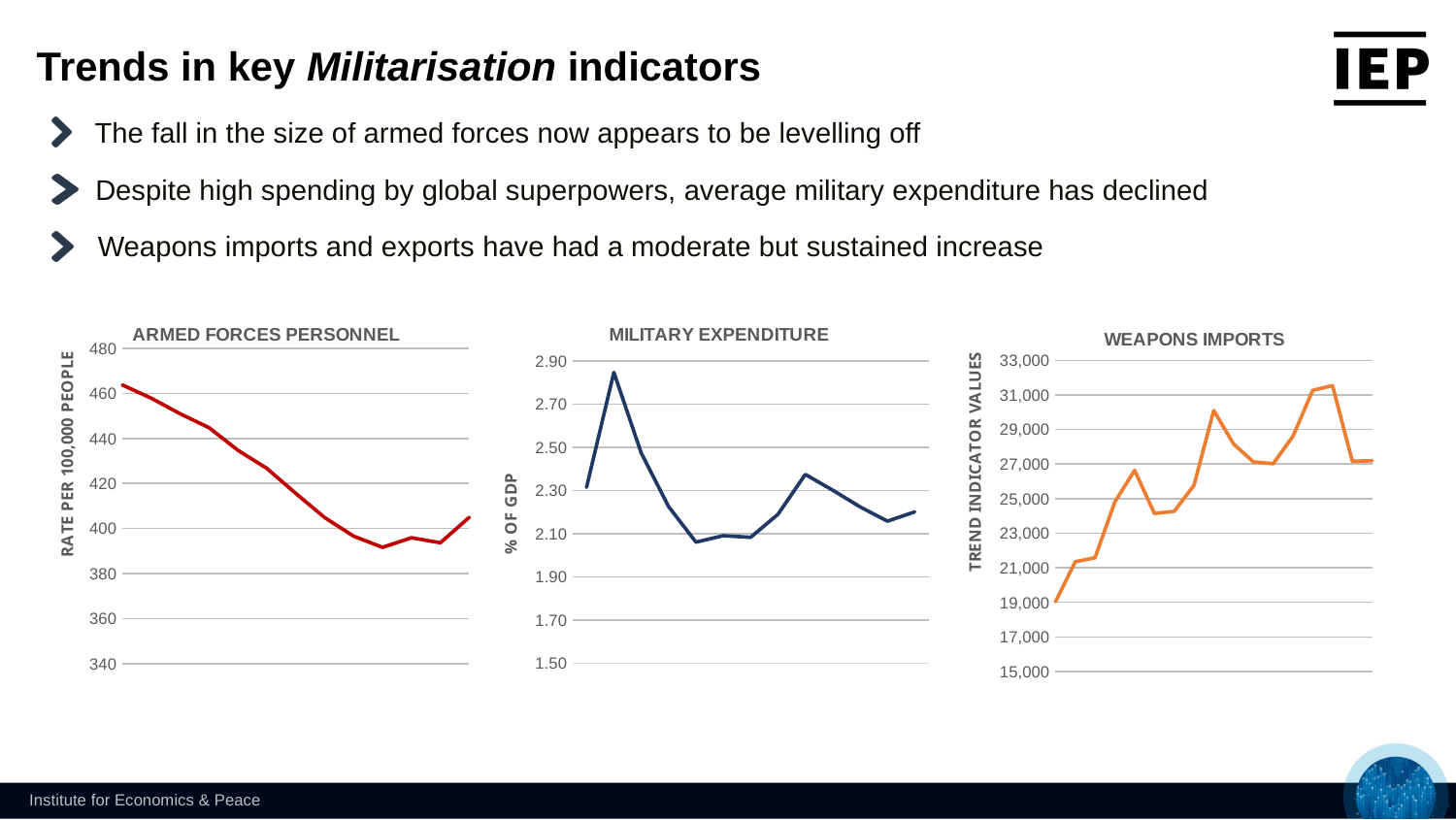
In the Armed Forces Personnel chart, is the first value greater or less than 440? greater In the Weapons Imports chart, is the last value greater or less than 25,000? greater In the Military Expenditure chart, is the peak value greater or less than 2.70? greater In the Weapons Imports chart, do the values mainly rise or fall from left to right? rise What is the y-axis label of the Military Expenditure chart? % OF GDP What colour is the line in the Weapons Imports chart? orange What kind of chart is the Armed Forces Personnel chart? line chart In the Armed Forces Personnel chart, do the values mainly rise or fall from left to right? fall